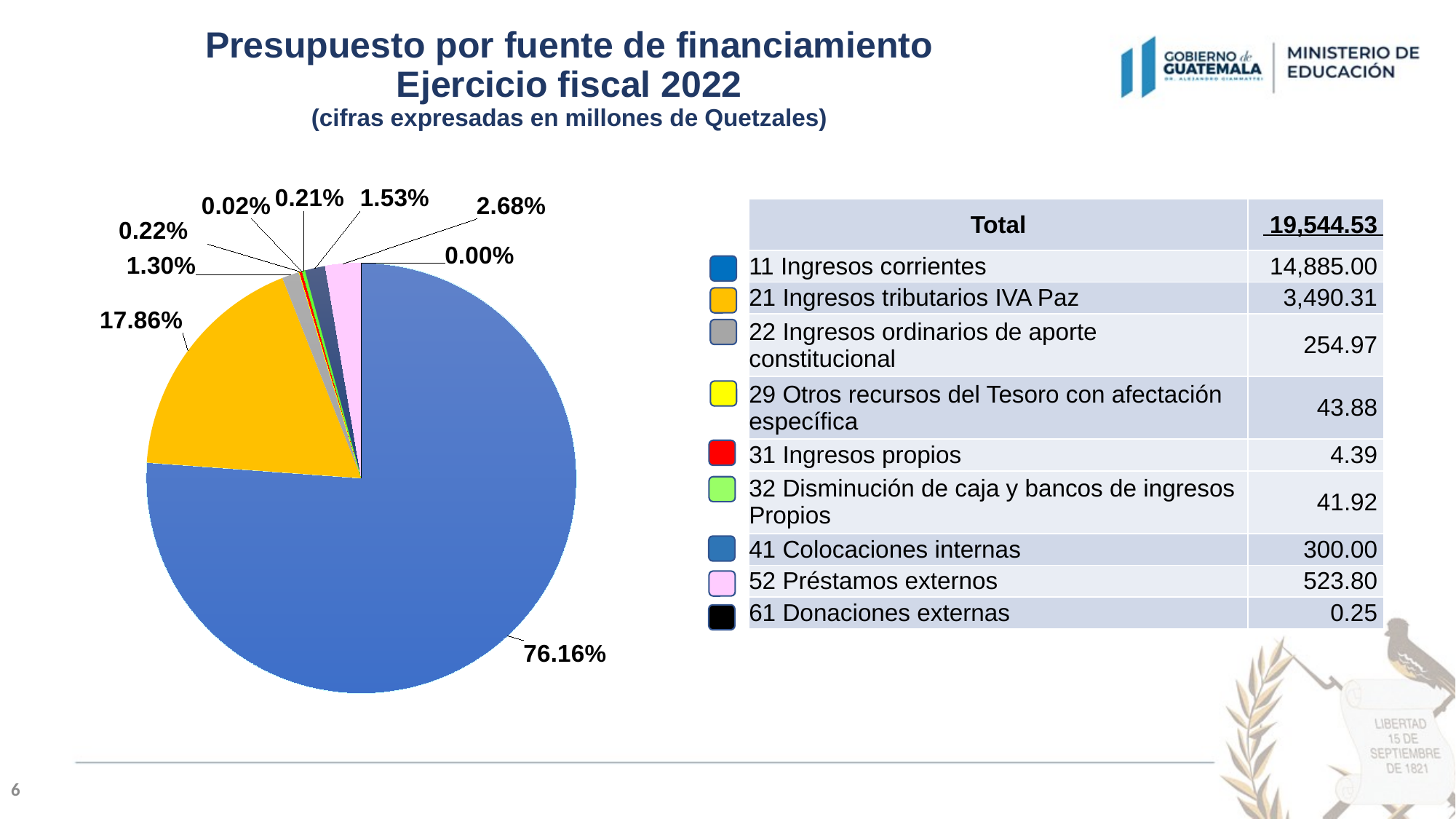
What percentage of the pie corresponds to 21 Ingresos tributarios IVA Paz? 17.86% What is the value shown for 22 Ingresos ordinarios de aporte constitucional? 254.97 Which funding source has the smallest slice of the pie? 61 Donaciones externas How many slices (funding sources) does the pie chart have? 9 Which funding source has the largest slice of the pie? 11 Ingresos corrientes What share of the pie does the largest slice, 11 Ingresos corrientes, represent? 76.16% What is the value shown for 41 Colocaciones internas? 300.00 What is the total budget shown at the top of the table? 19,544.53 What kind of chart is shown on the slide? pie chart What percentage label is shown for the 52 Préstamos externos slice? 2.68% What is the difference between the values for 11 Ingresos corrientes and 21 Ingresos tributarios IVA Paz? 11,394.69 Which is larger, 29 Otros recursos del Tesoro con afectación específica or 32 Disminución de caja y bancos de ingresos Propios? 29 Otros recursos del Tesoro con afectación específica